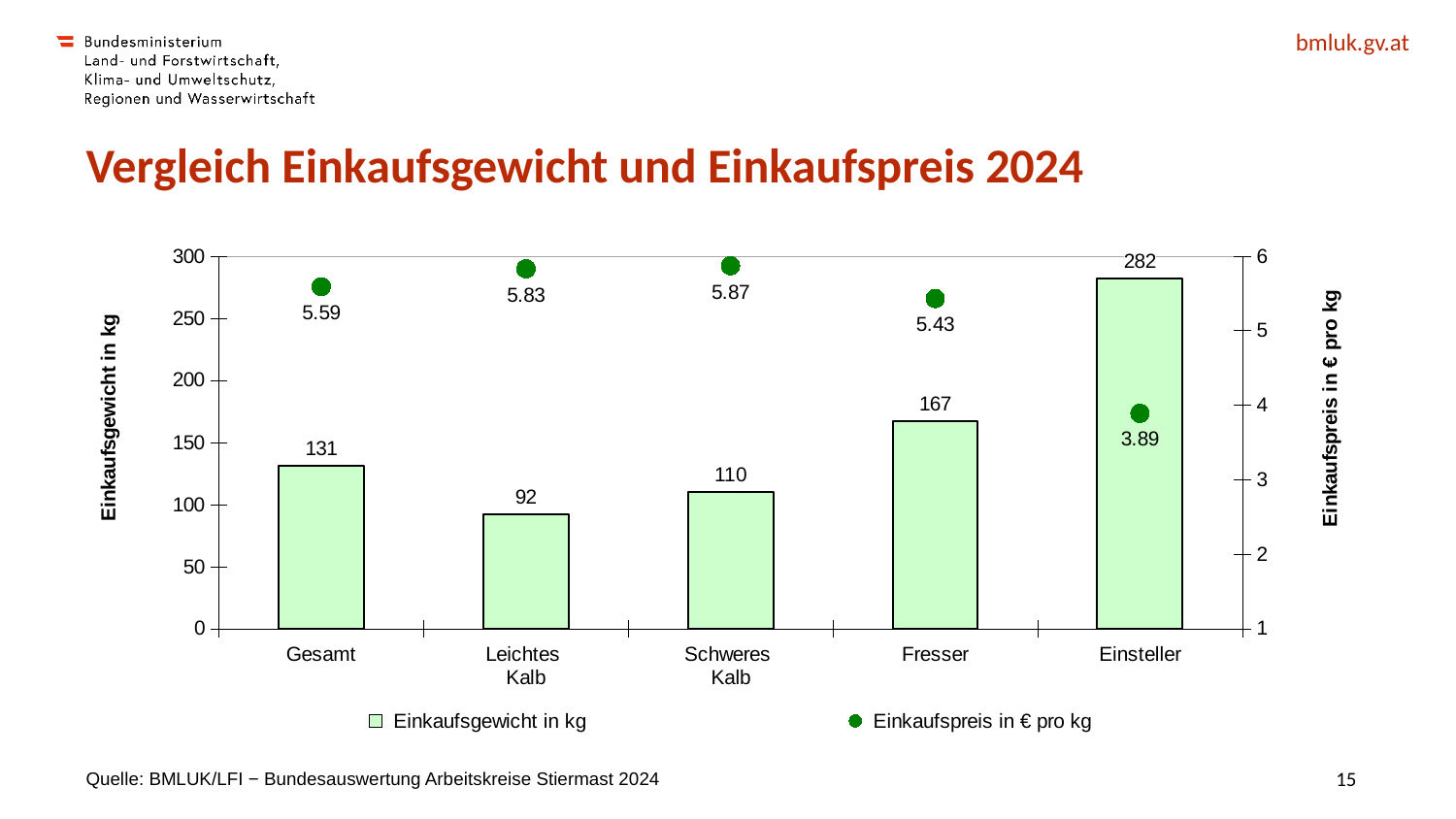
What is the Einkaufsgewicht in kg for Leichtes Kalb? 92 How many categories are shown on the x axis? 5 Which has a higher Einkaufspreis in € pro kg, Gesamt or Fresser? Gesamt Which category has the lowest Einkaufsgewicht in kg? Leichtes Kalb What is the difference in Einkaufsgewicht in kg between Einsteller and Fresser? 115 Which category has the highest Einkaufsgewicht in kg? Einsteller Which category has the lowest Einkaufspreis in € pro kg? Einsteller How many series does the legend list? 2 What kind of chart is shown on the slide? Combined bar and point chart What is the title of the chart on the slide? Vergleich Einkaufsgewicht und Einkaufspreis 2024 What is the Einkaufsgewicht in kg for Einsteller? 282 What is the Einkaufspreis in € pro kg for Schweres Kalb? 5.87